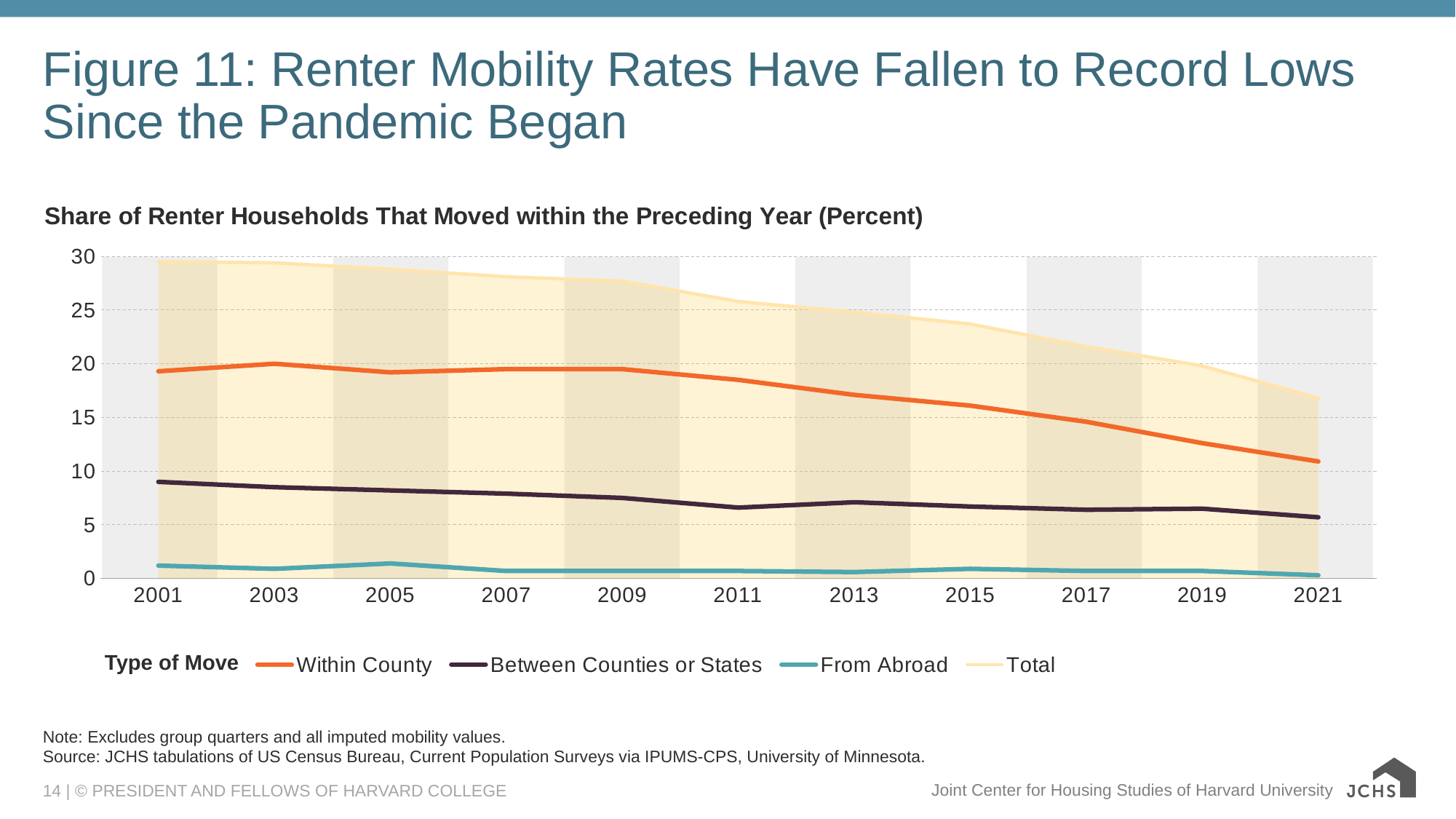
What is the title of the legend? Type of Move Does the Within County series rise or fall from 2009 to 2021? fall How many year labels are shown on the x axis? 11 How many series does the legend list? 4 What kind of chart is shown on the slide? combination area and line chart Is the value for Total in 2021 greater or less than 20? less Which series has the lowest values across all years? From Abroad In 2011, which is larger: Within County or Between Counties or States? Within County Is the value for Within County in 2001 greater or less than 15? greater Does the Total series rise or fall from 2001 to 2021? fall Is the value for Between Counties or States in 2021 greater or less than 10? less